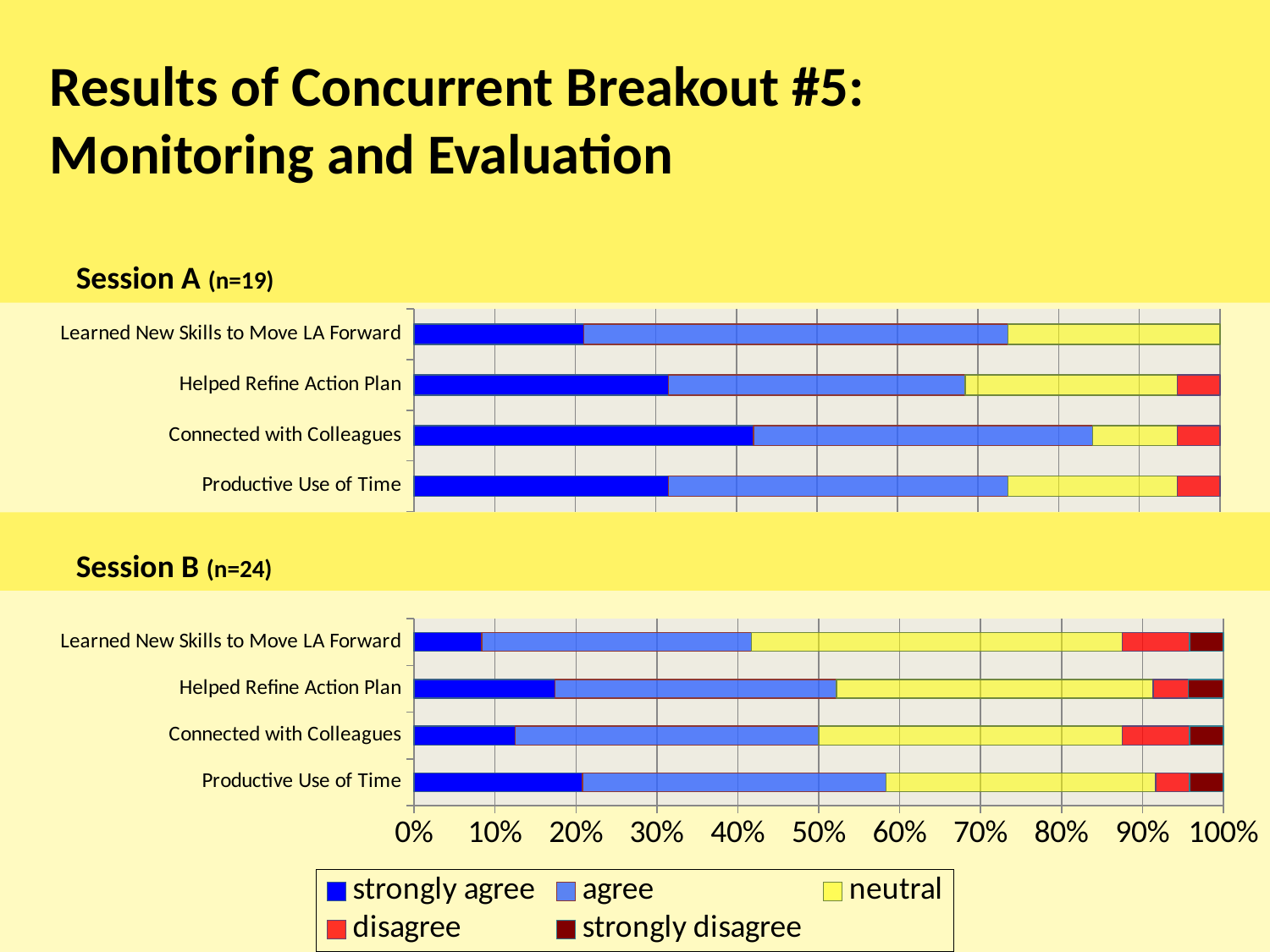
In the Session B (n=24) chart, is the strongly agree share for Productive Use of Time greater or less than 10%? greater In the Session A (n=19) chart, which category has the smallest strongly agree segment? Learned New Skills to Move LA Forward How many categories are plotted in the Session B (n=24) chart? 4 In the Session B (n=24) chart, is the strongly agree share for Learned New Skills to Move LA Forward greater or less than 10%? less In the Session A (n=19) chart, which category has the largest strongly agree segment? Connected with Colleagues What kind of chart is used for Session A (n=19)? stacked bar chart Which series is shown in dark red in the legend? strongly disagree How many series does the legend list? 5 In the Session B (n=24) chart, which category has the largest strongly agree segment? Productive Use of Time Which has the larger strongly agree segment: Connected with Colleagues in Session A or Connected with Colleagues in Session B? Session A In the Session A (n=19) chart, is the strongly agree share for Connected with Colleagues greater or less than 30%? greater In the Session B (n=24) chart, which category has the smallest strongly agree segment? Learned New Skills to Move LA Forward